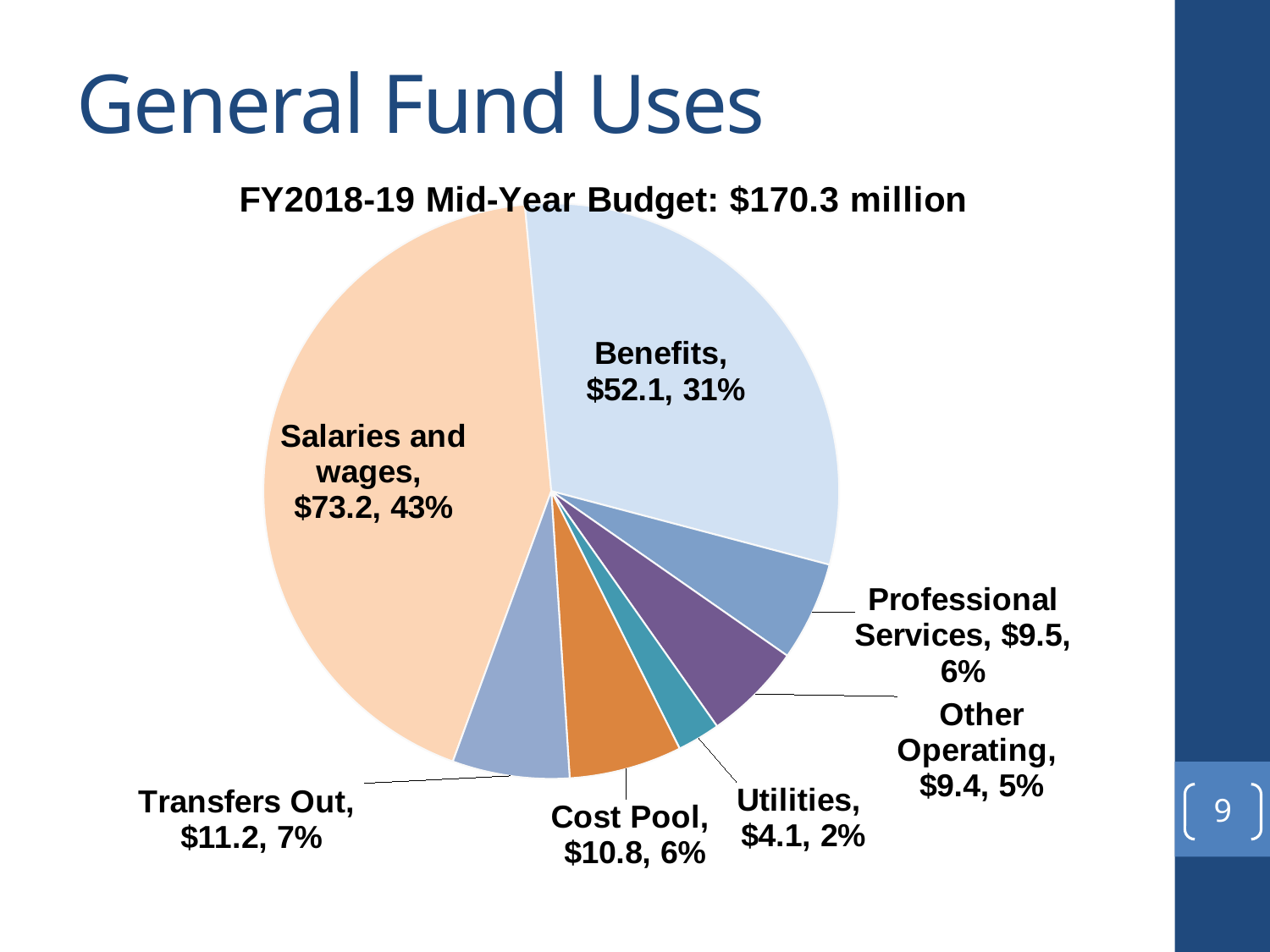
What is the title of the chart? FY2018-19 Mid-Year Budget: $170.3 million What is the dollar value shown for Transfers Out? $11.2 Which category has the largest slice of the pie? Salaries and wages What percentage share of the pie is Salaries and wages? 43% What percentage share of the pie is Other Operating? 5% Which is larger in dollar value, Cost Pool or Professional Services? Cost Pool What kind of chart is shown on the slide? Pie chart What is the difference in dollar value between Salaries and wages and Benefits? $21.1 What is the dollar value shown for Benefits? $52.1 What is the dollar value shown for Utilities? $4.1 How many slices does the pie chart have? 7 Which category has the smallest slice of the pie? Utilities